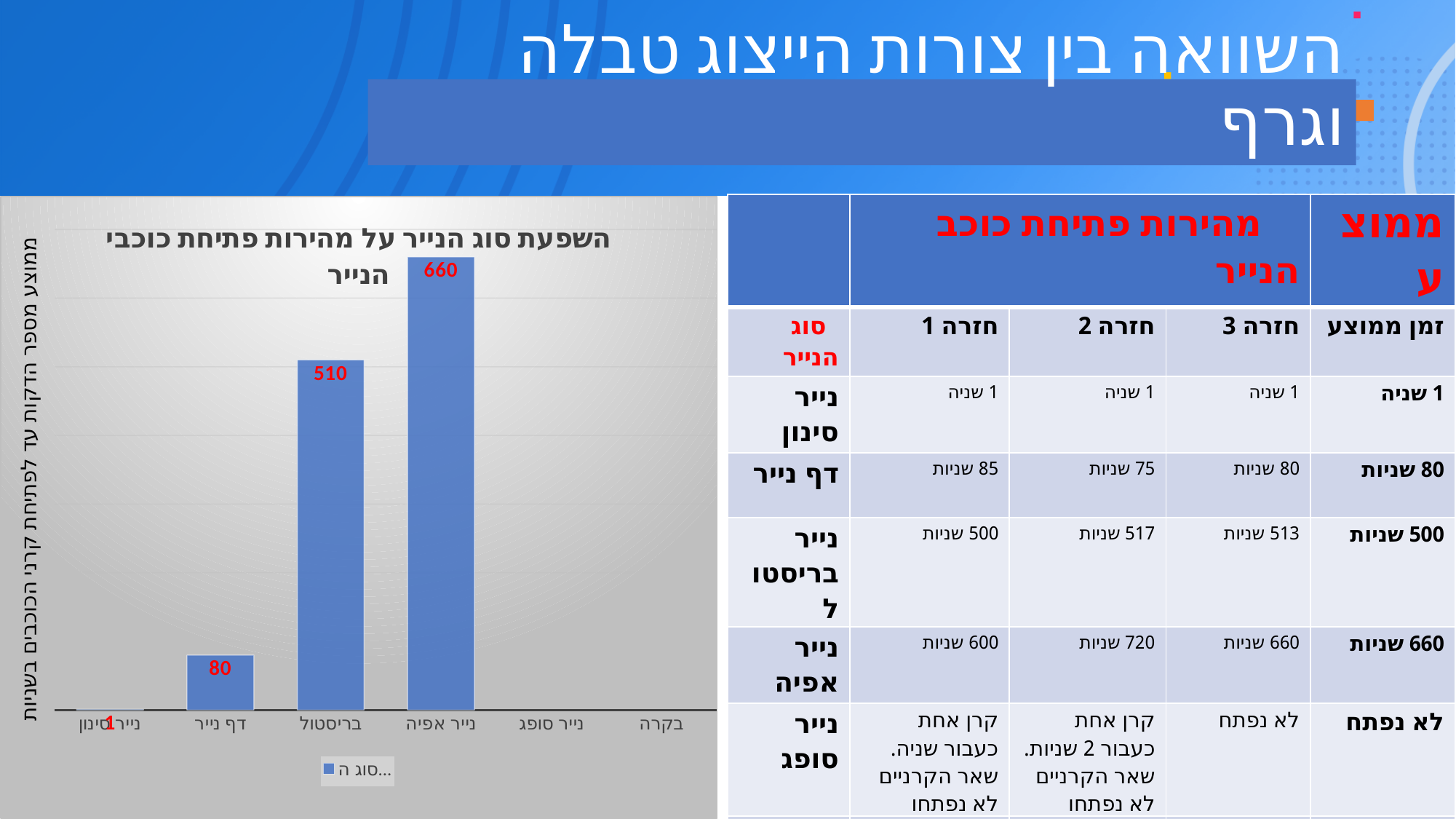
What is the value for דף נייר in the bar chart? 80 What is the value for בריסטול in the bar chart? 510 What is the title of the bar chart? השפעת סוג הנייר על מהירות פתיחת כוכבי הנייר What type of chart is shown on the slide? bar chart What is the value for נייר אפיה in the bar chart? 660 What is the value for נייר סינון in the bar chart? 1 Which is larger, the value for דף נייר or the value for בריסטול? בריסטול What is the difference between the values for בריסטול and דף נייר? 430 How many categories are shown on the x axis of the bar chart? 6 What is the difference between the values for נייר אפיה and בריסטול? 150 Which category has the highest value in the bar chart? נייר אפיה What colour are the bars in the chart? blue